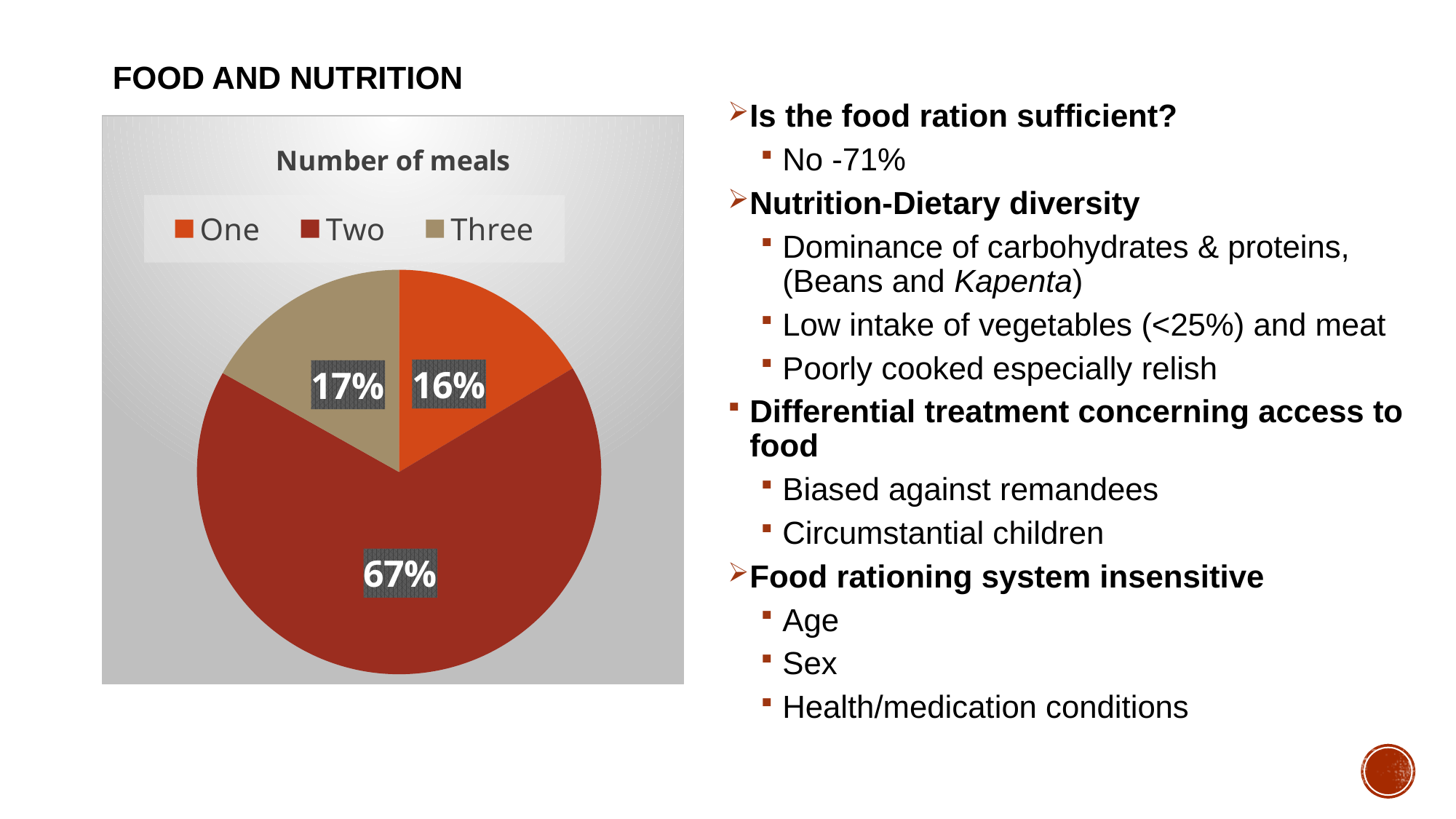
What share of the pie is labelled "Three"? 17% What share of the pie is labelled "One"? 16% How many categories does the pie chart show? 3 What is the title of the chart? Number of meals What kind of chart is shown on the slide? pie chart What is the difference in percentage points between the "Three" slice and the "One" slice? 1% What is the difference in percentage points between the "Two" slice and the "Three" slice? 50% Which category has the largest slice of the pie? Two How many entries does the legend list? 3 Which category has the smallest slice of the pie? One Which colour represents "Three" in the legend? tan/beige What share of the pie is labelled "Two"? 67%